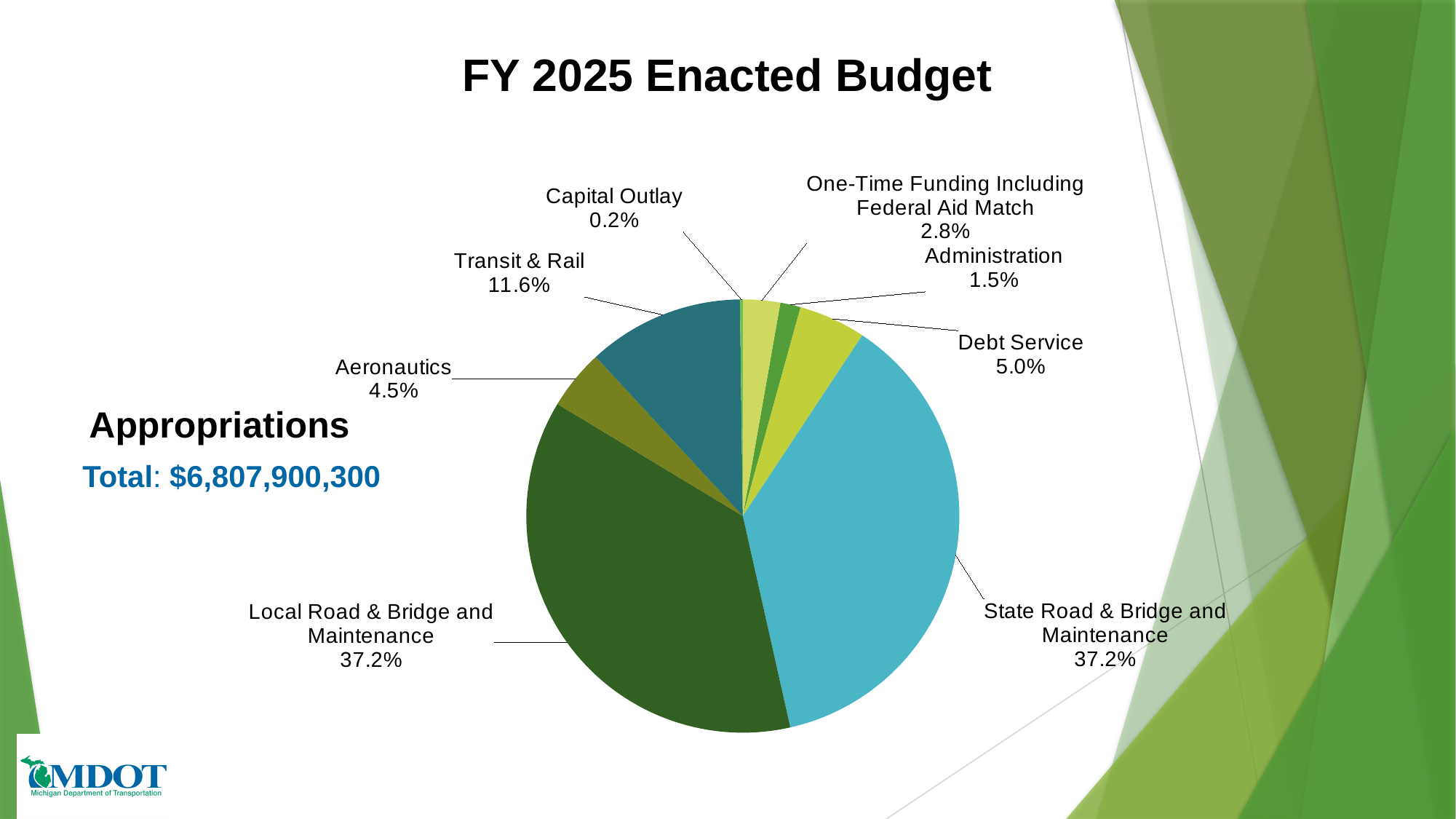
Which is larger, Transit & Rail or Debt Service? Transit & Rail What share of the pie does Aeronautics represent? 4.5% What total appropriations amount is stated on the slide? $6,807,900,300 How many slices does the pie chart have? 8 What is the title of the chart? FY 2025 Enacted Budget What share of the pie does Debt Service represent? 5.0% What kind of chart is shown on the slide? Pie chart What share of the pie does Transit & Rail represent? 11.6% Which category has the smallest slice of the pie? Capital Outlay What percentage is shown for One-Time Funding Including Federal Aid Match? 2.8% What percentage is shown for Administration? 1.5% What is the difference in percentage points between Transit & Rail and Debt Service? 6.6